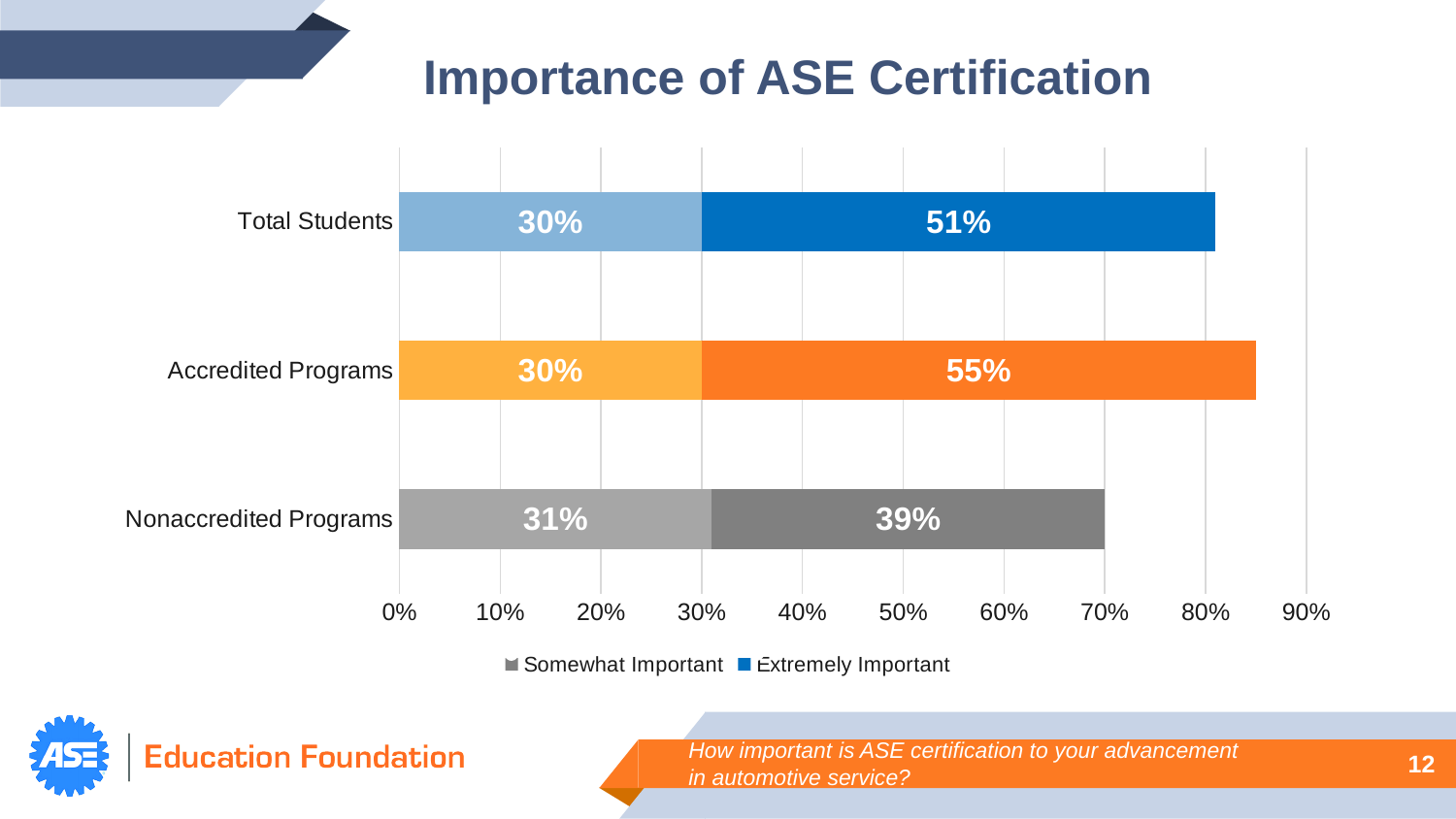
How many categories are shown on the chart? 3 What percentage of Accredited Programs students rated ASE certification as Somewhat Important? 30% Which is larger: the Extremely Important percentage for Total Students or for Nonaccredited Programs? Total Students What is the combined total of Somewhat Important and Extremely Important for Nonaccredited Programs? 70% How many series does the legend list? 2 What percentage of Total Students rated ASE certification as Extremely Important? 51% What type of chart is shown on the slide? Stacked bar chart What is the difference between the Extremely Important percentages for Accredited Programs and Nonaccredited Programs? 16% Which category has the lowest Extremely Important percentage? Nonaccredited Programs What is the combined total of Somewhat Important and Extremely Important for Accredited Programs? 85% What percentage of Nonaccredited Programs students rated ASE certification as Extremely Important? 39% Which category has the highest Extremely Important percentage? Accredited Programs